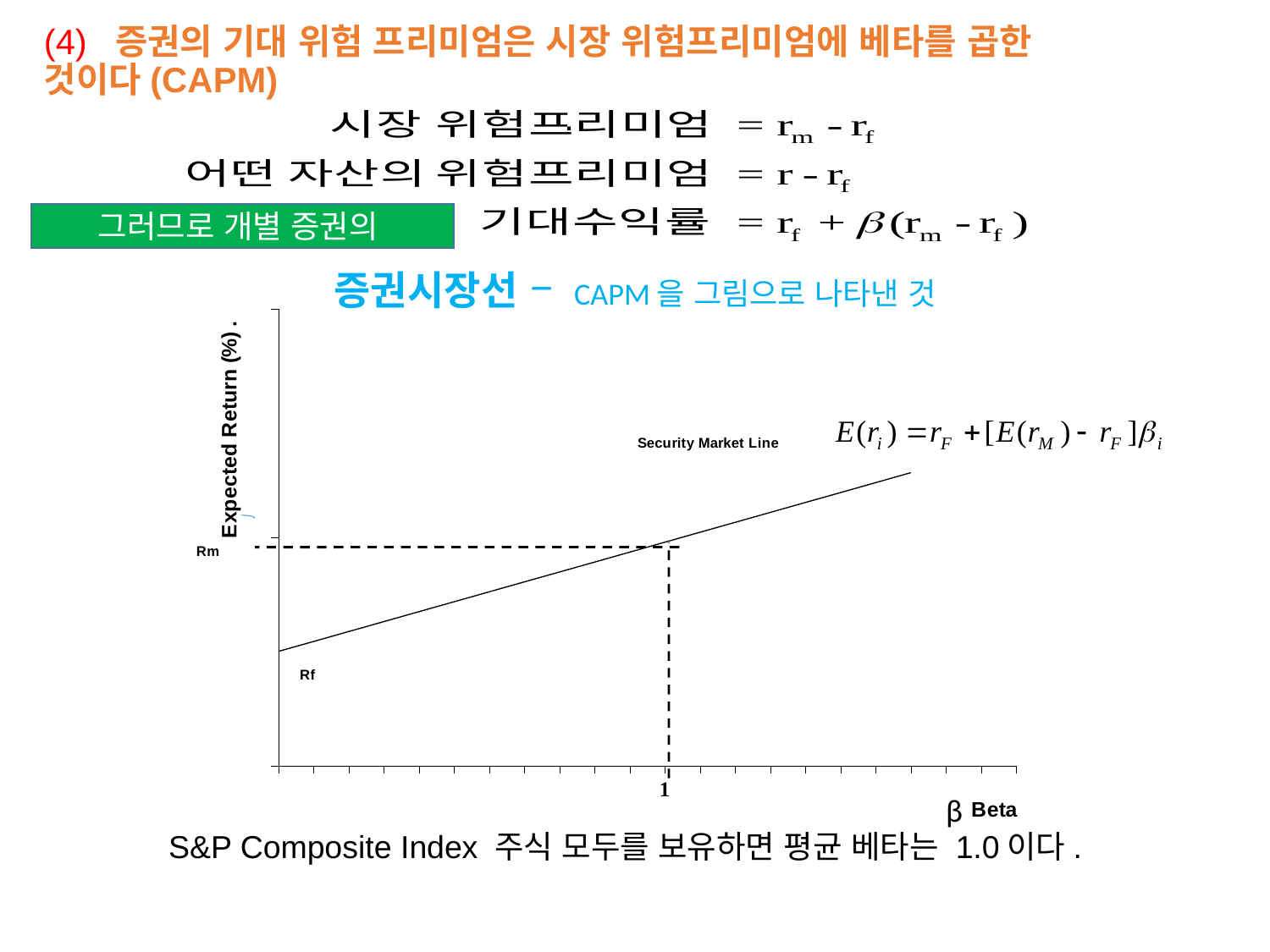
Which is larger on the chart, Rm or Rf? Rm At what Beta value does the vertical dashed line meet the x axis? 1 What kind of chart is shown on the slide? line chart What is the name of the line plotted on the chart? Security Market Line What is the label of the x axis of the chart? Beta Which label marks the expected return where the dashed lines meet the Security Market Line? Rm Does the Security Market Line rise or fall as Beta increases? rise Which label marks the point where the Security Market Line meets the y axis? Rf What is the label of the y axis of the chart? Expected Return (%)